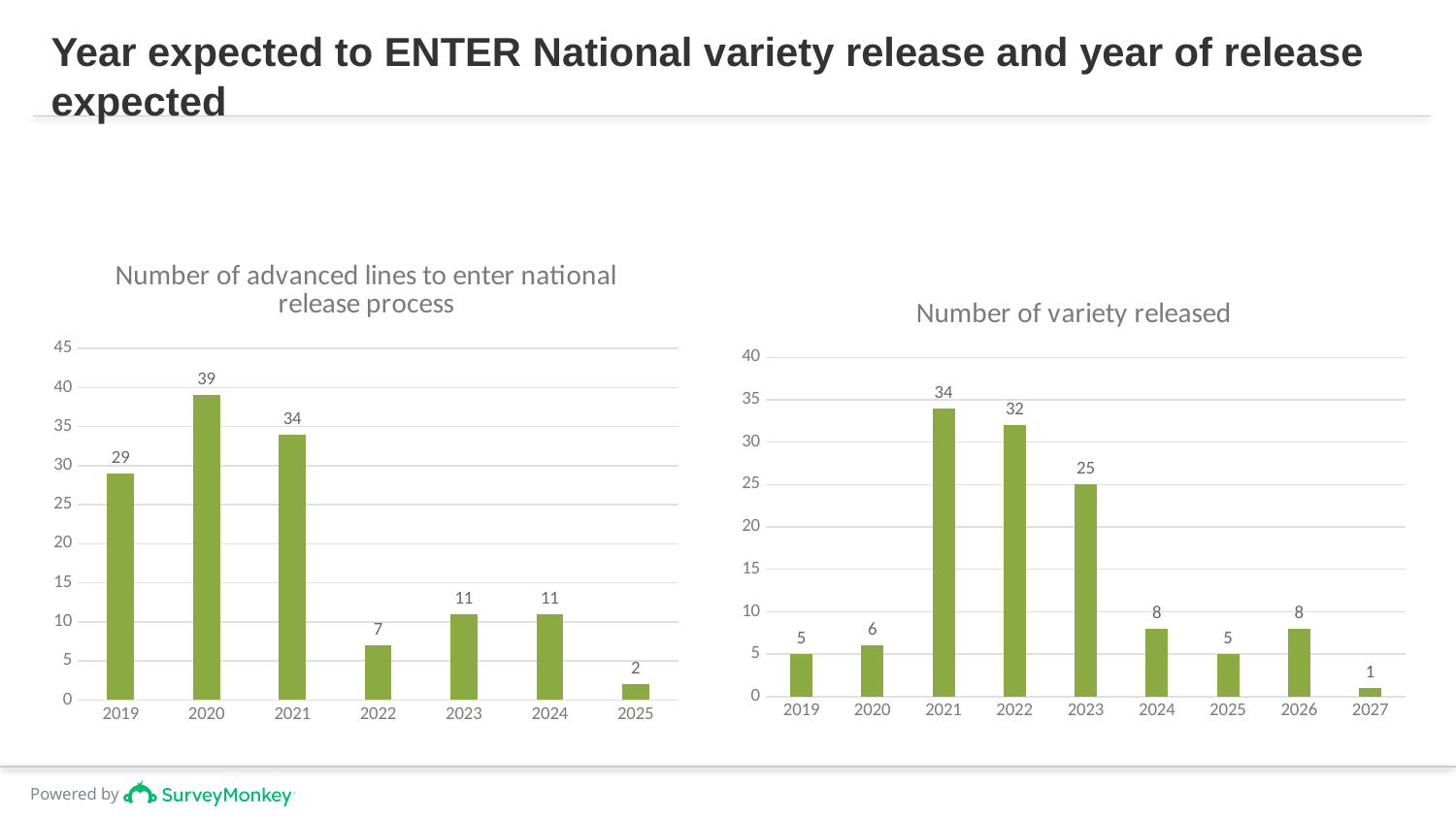
How many years are shown on the x axis of the 'Number of advanced lines to enter national release process' chart? 7 In the 'Number of variety released' chart, which is larger, the value for 2019 or the value for 2020? 2020 In the 'Number of variety released' chart, what is the difference between the values for 2021 and 2022? 2 In the 'Number of advanced lines to enter national release process' chart, what is the difference between the values for 2020 and 2021? 5 How many years are shown on the x axis of the 'Number of variety released' chart? 9 In the 'Number of variety released' chart, what is the value for 2023? 25 In the 'Number of advanced lines to enter national release process' chart, which year has the lowest value? 2025 What kind of chart is the 'Number of variety released' chart? Bar chart In the 'Number of variety released' chart, which year has the highest value? 2021 In the 'Number of advanced lines to enter national release process' chart, is the value for 2019 greater or less than 25? greater In the 'Number of advanced lines to enter national release process' chart, what is the value for 2020? 39